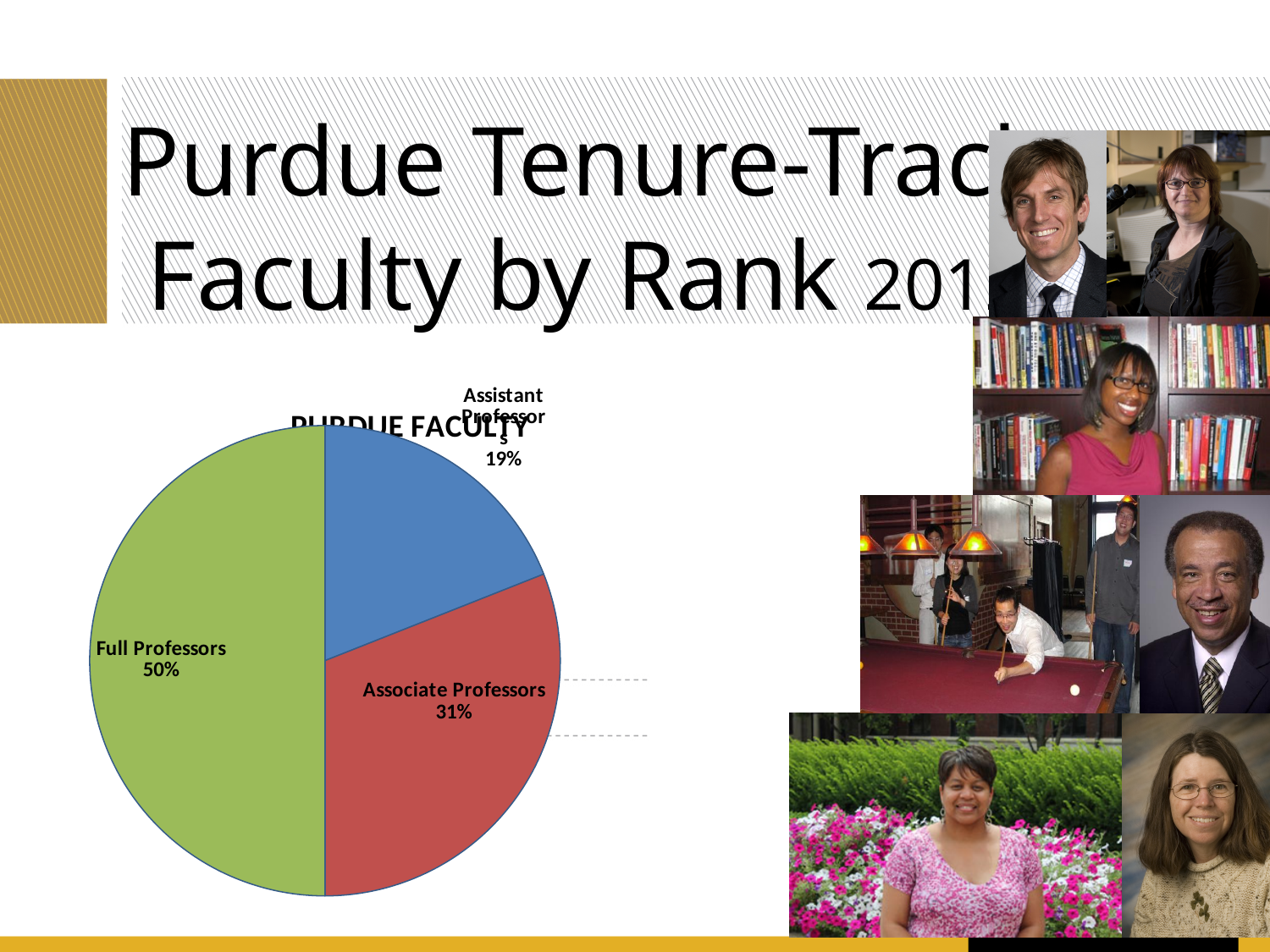
Which is larger, the Associate Professors slice or the Assistant Professors slice? Associate Professors Which category has the largest slice of the pie? Full Professors What kind of chart is shown on the slide? Pie chart What colour is the Full Professors slice? Green Which category has the smallest slice of the pie? Assistant Professors What is the difference in percentage points between Associate Professors and Assistant Professors? 12 What is the difference in percentage points between Full Professors and Associate Professors? 19 What share of the pie does Assistant Professors hold? 19% What is the title of the chart? PURDUE FACULTY How many categories are shown in the pie chart? 3 What share of the pie does Full Professors hold? 50% What share of the pie does Associate Professors hold? 31%